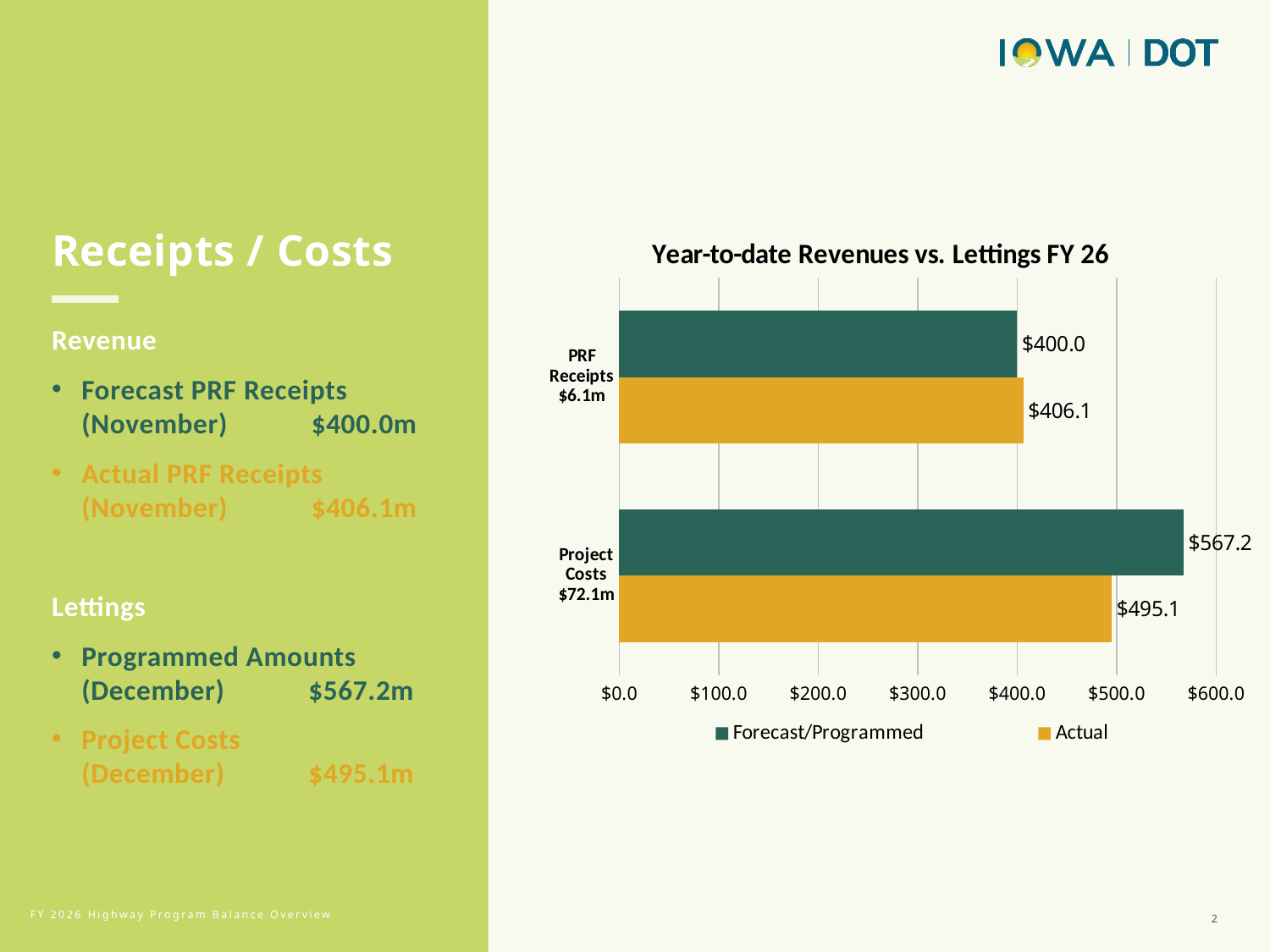
Which bar in the chart has the highest value? Project Costs, Forecast/Programmed What is the difference between the Actual and Forecast/Programmed values for PRF Receipts? $6.1 What is the Actual value for Project Costs? $495.1 What kind of chart is shown on the slide? Bar chart What is the title of the chart? Year-to-date Revenues vs. Lettings FY 26 What is the Forecast/Programmed value for Project Costs? $567.2 What is the difference between the Forecast/Programmed and Actual values for Project Costs? $72.1 How many series does the legend list? 2 Which bar in the chart has the lowest value? PRF Receipts, Forecast/Programmed What is the Forecast/Programmed value for PRF Receipts? $400.0 For Project Costs, which is larger: the Forecast/Programmed value or the Actual value? Forecast/Programmed What is the Actual value for PRF Receipts? $406.1